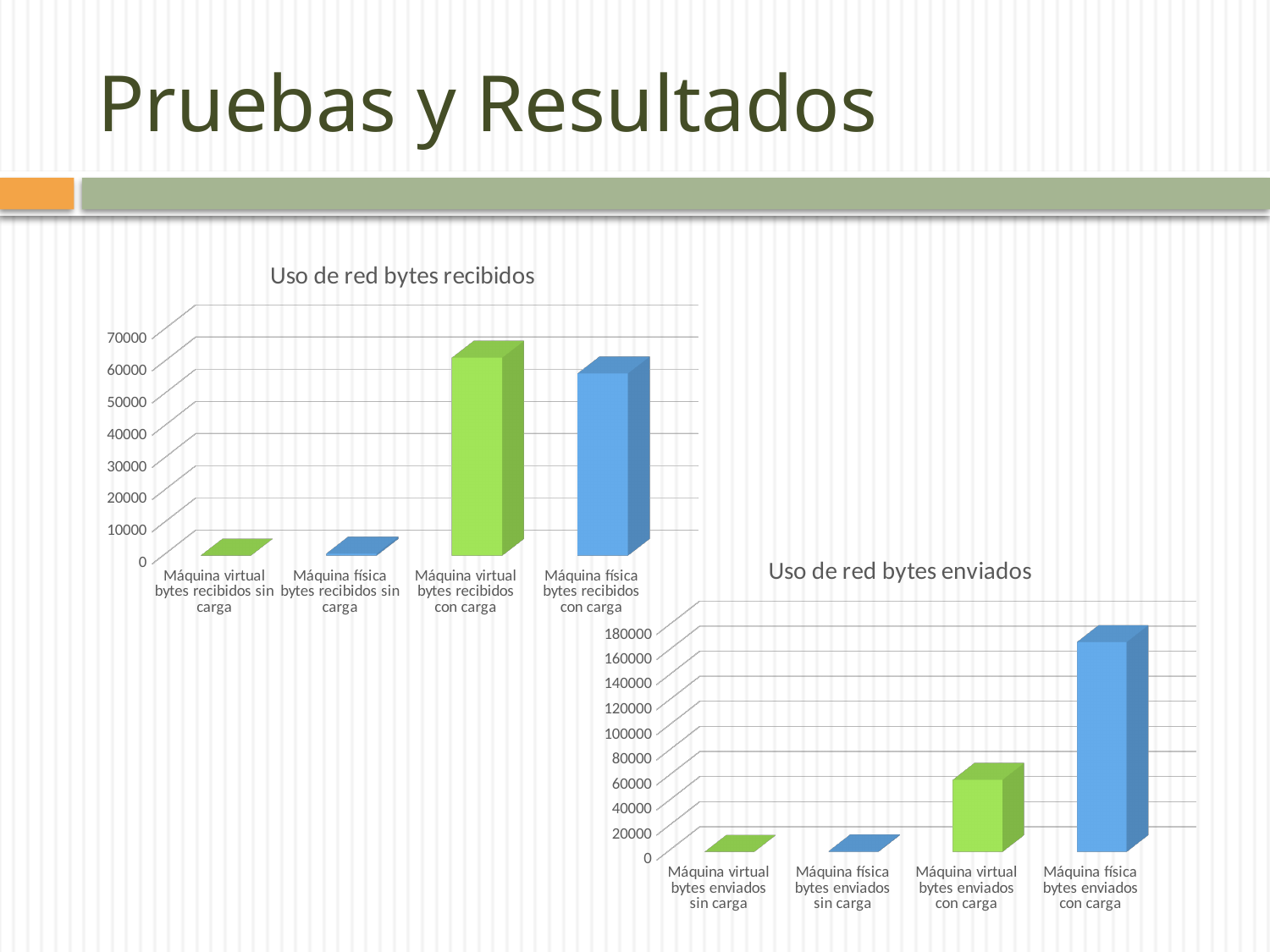
In the 'Uso de red bytes recibidos' chart, which category has the highest value? Máquina virtual bytes recibidos con carga In the 'Uso de red bytes enviados' chart, which is larger: 'Máquina física bytes enviados con carga' or 'Máquina virtual bytes enviados con carga'? Máquina física bytes enviados con carga In the 'Uso de red bytes recibidos' chart, is the value for 'Máquina física bytes recibidos sin carga' greater or less than 10000? less In the 'Uso de red bytes recibidos' chart, which is larger: 'Máquina física bytes recibidos con carga' or 'Máquina física bytes recibidos sin carga'? Máquina física bytes recibidos con carga How many categories are shown in the 'Uso de red bytes enviados' chart? 4 In the 'Uso de red bytes enviados' chart, is the value for 'Máquina virtual bytes enviados con carga' greater or less than 100000? less What type of chart is 'Uso de red bytes enviados'? bar chart In the 'Uso de red bytes enviados' chart, which category has the highest value? Máquina física bytes enviados con carga In the 'Uso de red bytes enviados' chart, is the value for 'Máquina física bytes enviados con carga' greater or less than 140000? greater What type of chart is 'Uso de red bytes recibidos'? bar chart How many categories are shown in the 'Uso de red bytes recibidos' chart? 4